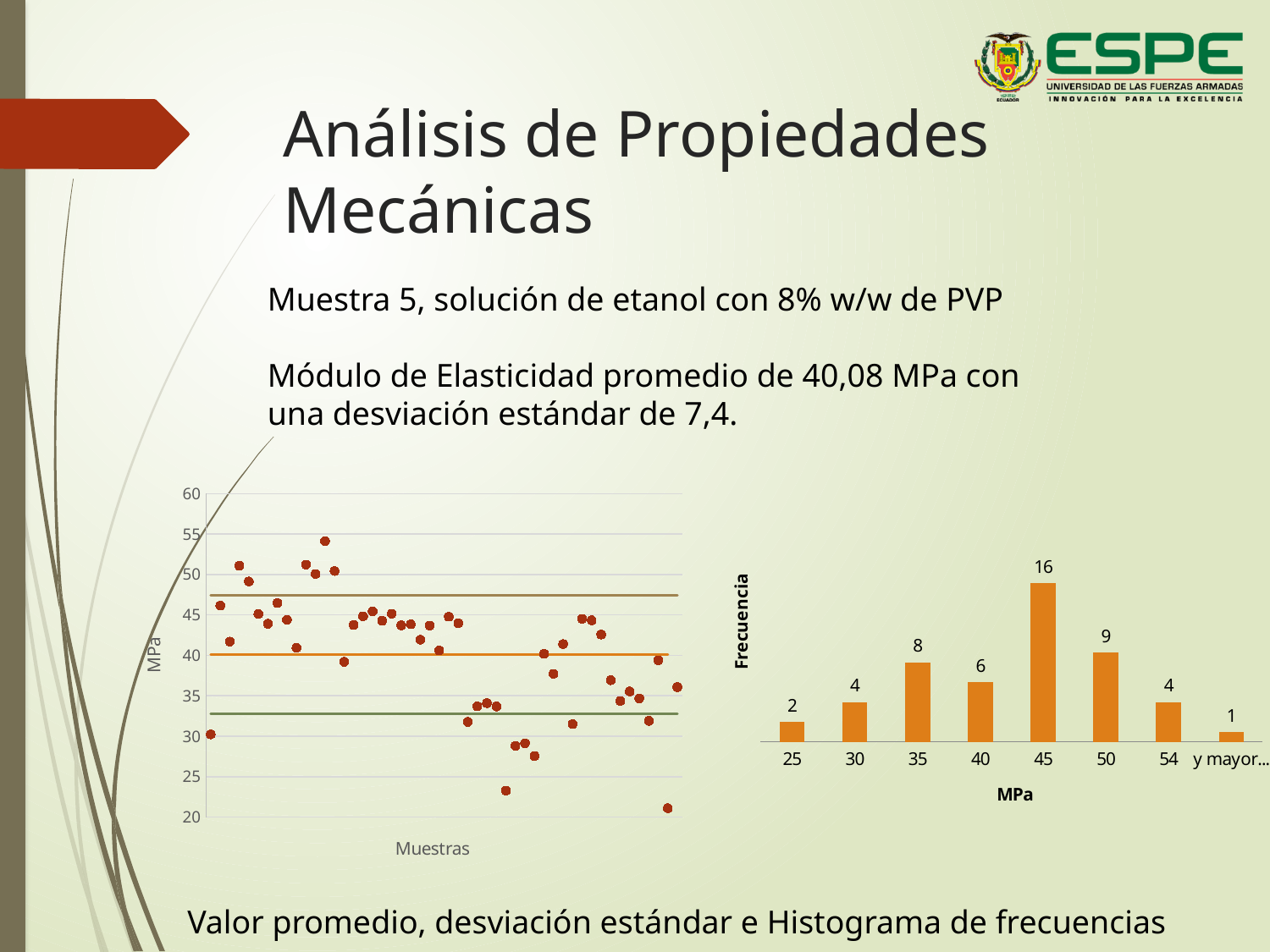
In the histogram on the right, how many bins are shown on the x axis? 8 In the histogram on the right, what is the frequency for the 45 MPa bin? 16 What is the x-axis title of the chart on the left of the slide? Muestras In the histogram on the right, which bin has the lowest frequency? y mayor... What kind of chart is the chart on the right of the slide? Bar chart In the histogram on the right, what is the frequency for the 35 MPa bin? 8 In the histogram on the right, what is the frequency for the 25 MPa bin? 2 In the histogram on the right, which bin has a higher frequency, 35 or 40? 35 In the histogram on the right, what is the difference between the frequencies of the 45 and 50 MPa bins? 7 In the histogram on the right, which MPa bin has the highest frequency? 45 In the histogram on the right, what is the total frequency across all bins? 50 What kind of chart is the chart on the left of the slide? Scatter chart